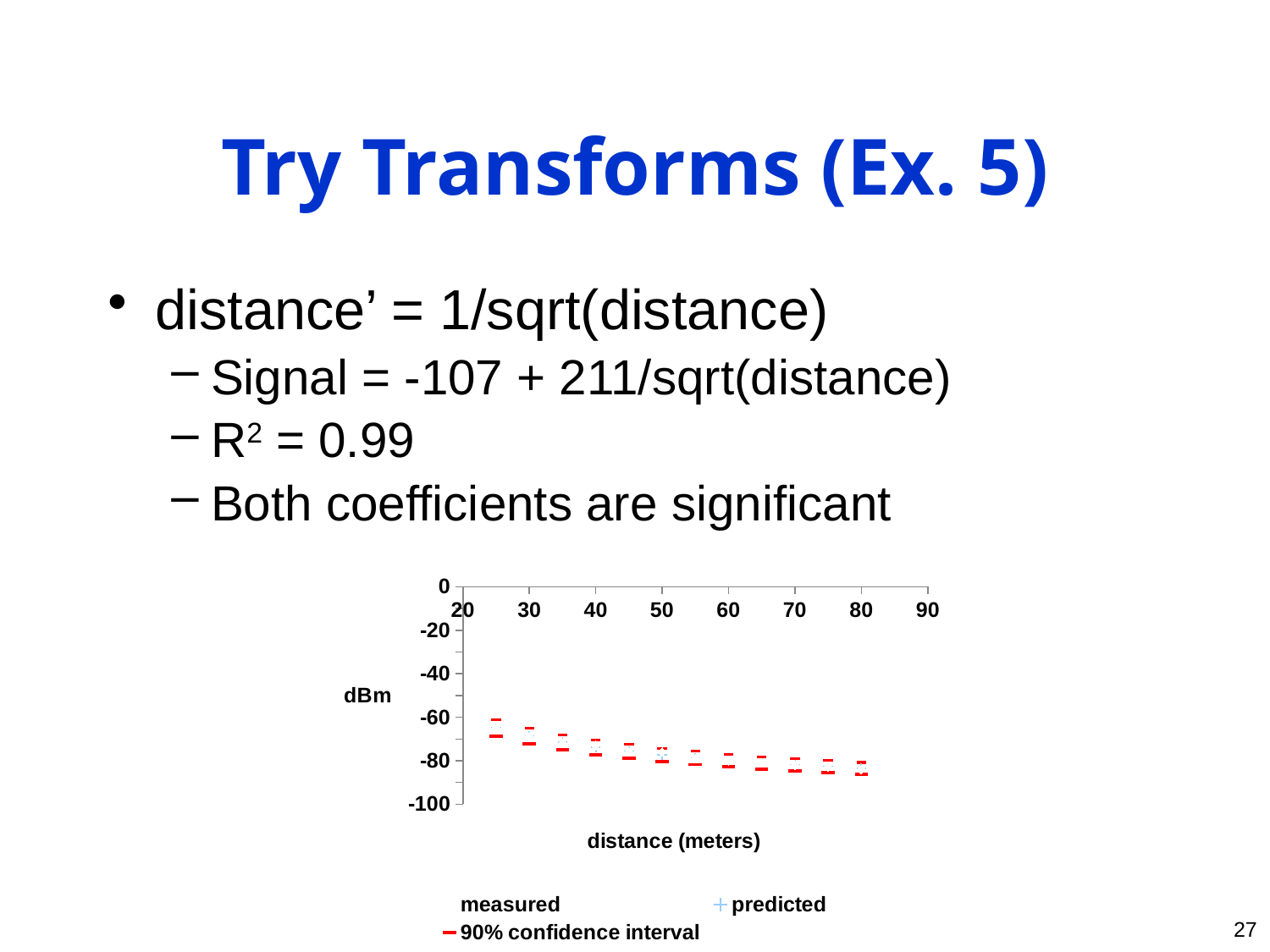
Which is larger, the measured signal at about 25 meters or at about 80 meters? 25 meters Do the measured signal values rise or fall as distance increases along the x axis? fall How many series does the chart legend list? 3 What kind of chart is shown on the slide? scatter plot Is the measured value at a distance of about 25 meters greater or less than -80 dBm? greater What is the label of the x axis of the chart? distance (meters) Is the measured value at a distance of about 25 meters greater or less than -40 dBm? less Is the measured value at a distance of about 80 meters greater or less than -60 dBm? less What is the highest value shown on the y axis of the chart? 0 What is the label of the y axis of the chart? dBm